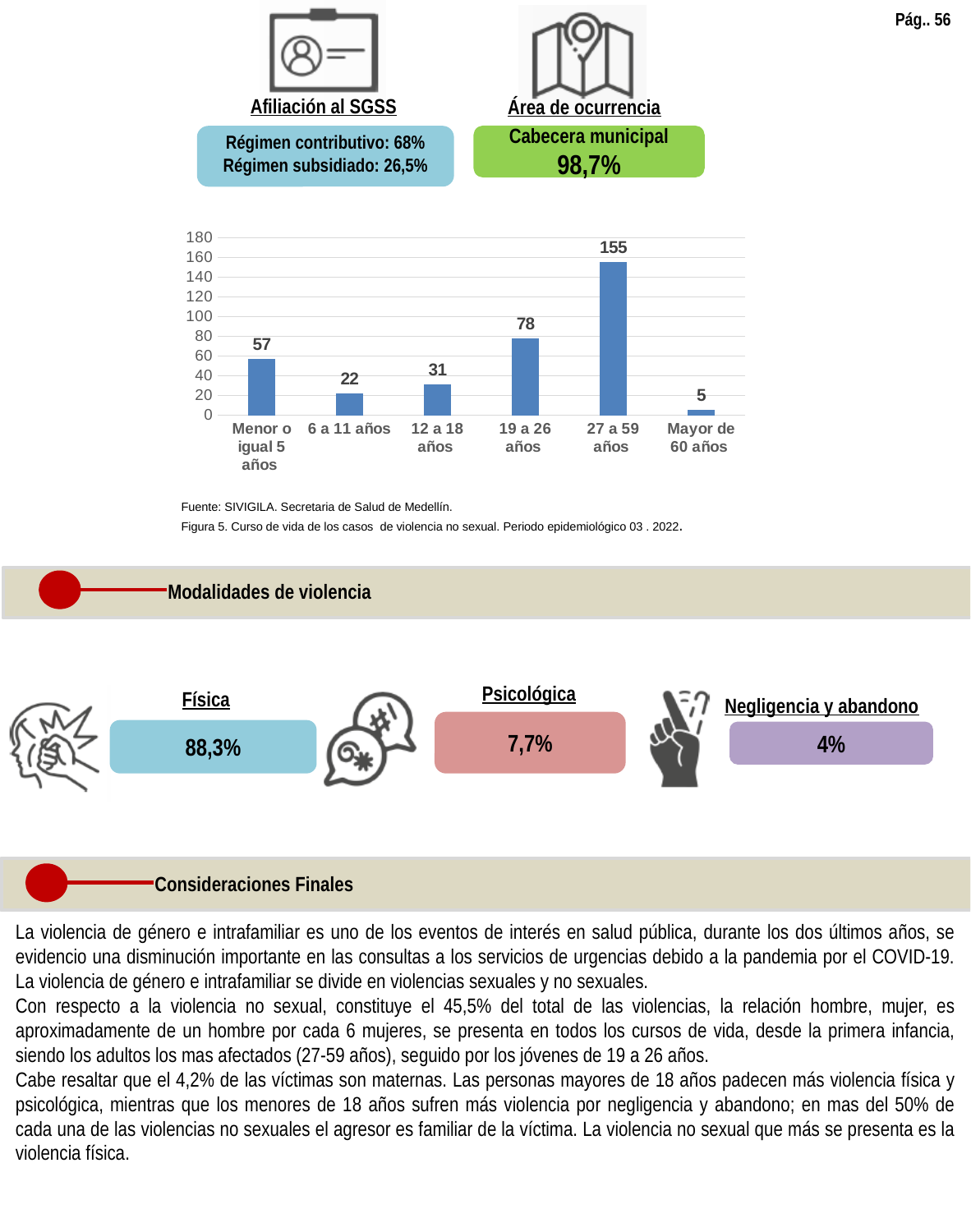
Which is larger in the bar chart: the value for '12 a 18 años' or the value for '6 a 11 años'? 12 a 18 años What is the difference between the values for '27 a 59 años' and '19 a 26 años' in the bar chart? 77 What type of chart is used to show the cases by age group? bar chart Which age group has the highest value in the bar chart? 27 a 59 años What is the value for the 'Menor o igual 5 años' category in the bar chart? 57 Is the value for '19 a 26 años' in the bar chart greater or less than 100? less What is the value for the 'Mayor de 60 años' category in the bar chart? 5 What is the highest value shown on the vertical axis of the bar chart? 180 How many age categories are shown in the bar chart? 6 What is the value for the '6 a 11 años' category in the bar chart? 22 What is the value for the '27 a 59 años' category in the bar chart? 155 Which age group has the lowest value in the bar chart? Mayor de 60 años